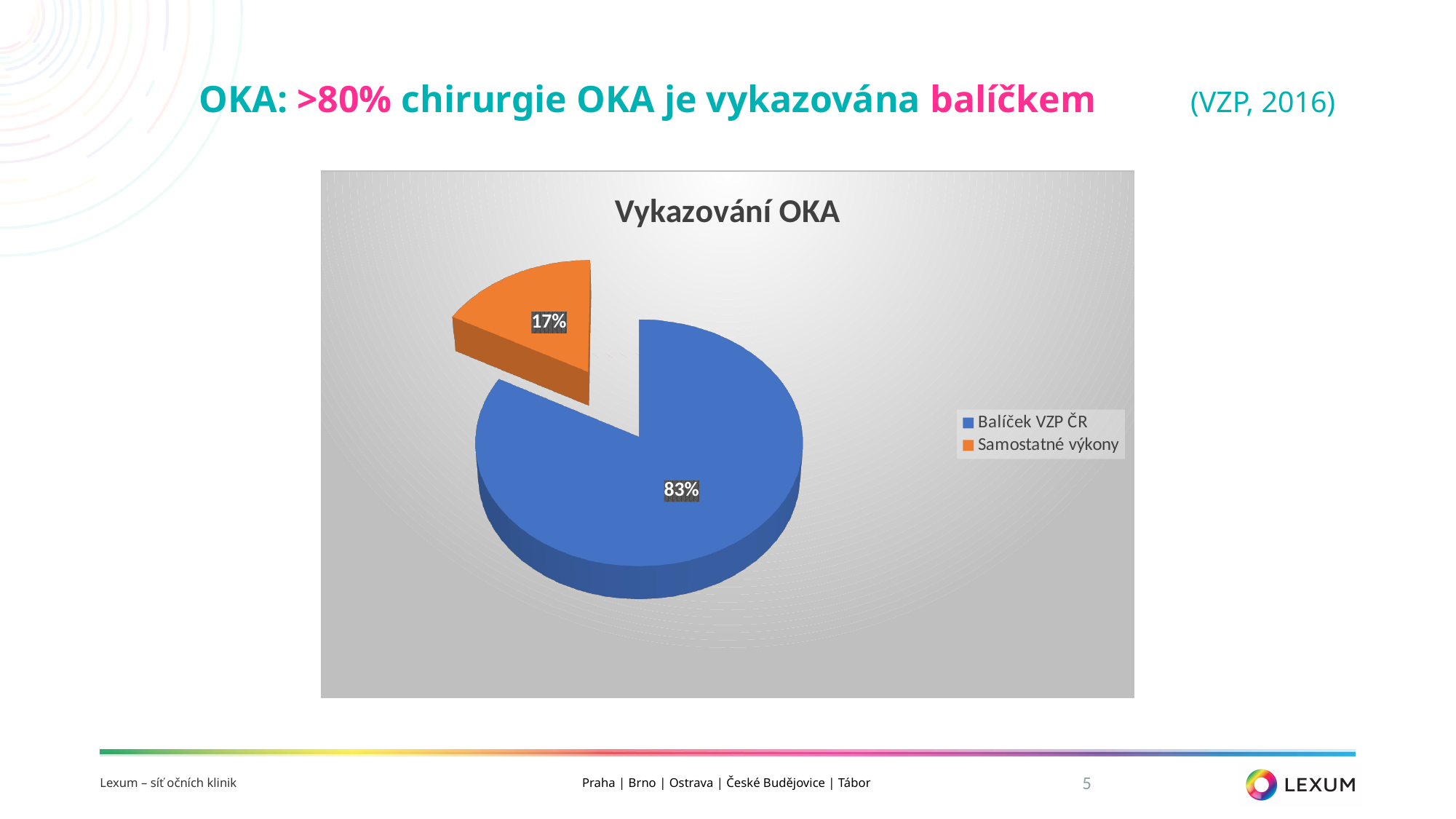
What share of the pie does Samostatné výkony represent? 17% Which category has the largest slice of the pie? Balíček VZP ČR What share of the pie does Balíček VZP ČR represent? 83% Which is larger, the share for Balíček VZP ČR or for Samostatné výkony? Balíček VZP ČR Which category has the smallest slice of the pie? Samostatné výkony What is the title of the chart? Vykazování OKA What kind of chart is shown on the slide? Pie chart What is the total of the two slices shown in the pie chart? 100% How many categories does the pie chart show? 2 What is the difference in percentage points between Balíček VZP ČR and Samostatné výkony? 66 What colour is the slice for Samostatné výkony? Orange